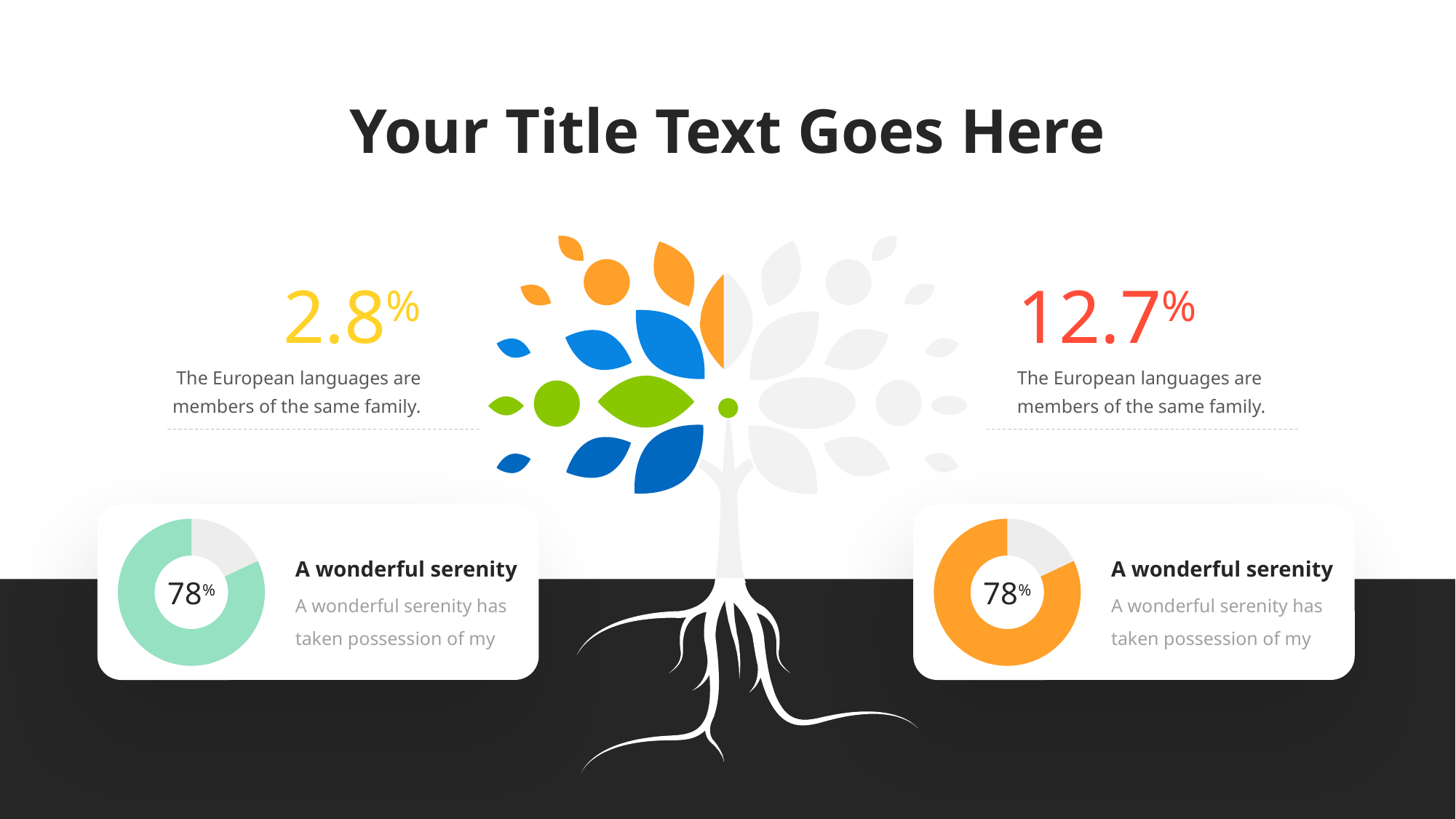
Which donut chart shows the larger value, the left one or the right one? They are equal (both 78%) What kind of chart is the chart on the left side of the slide? Donut chart Is the value shown in the right donut chart greater or less than 50%? greater What value is shown in the centre of the right donut chart? 78% What kind of chart is the chart on the right side of the slide? Donut chart What colour is the filled portion of the left donut chart? Green What colour is the filled portion of the right donut chart? Orange How many donut charts are on the slide? 2 What value is shown in the centre of the left donut chart? 78% Is the value shown in the left donut chart greater or less than 50%? greater